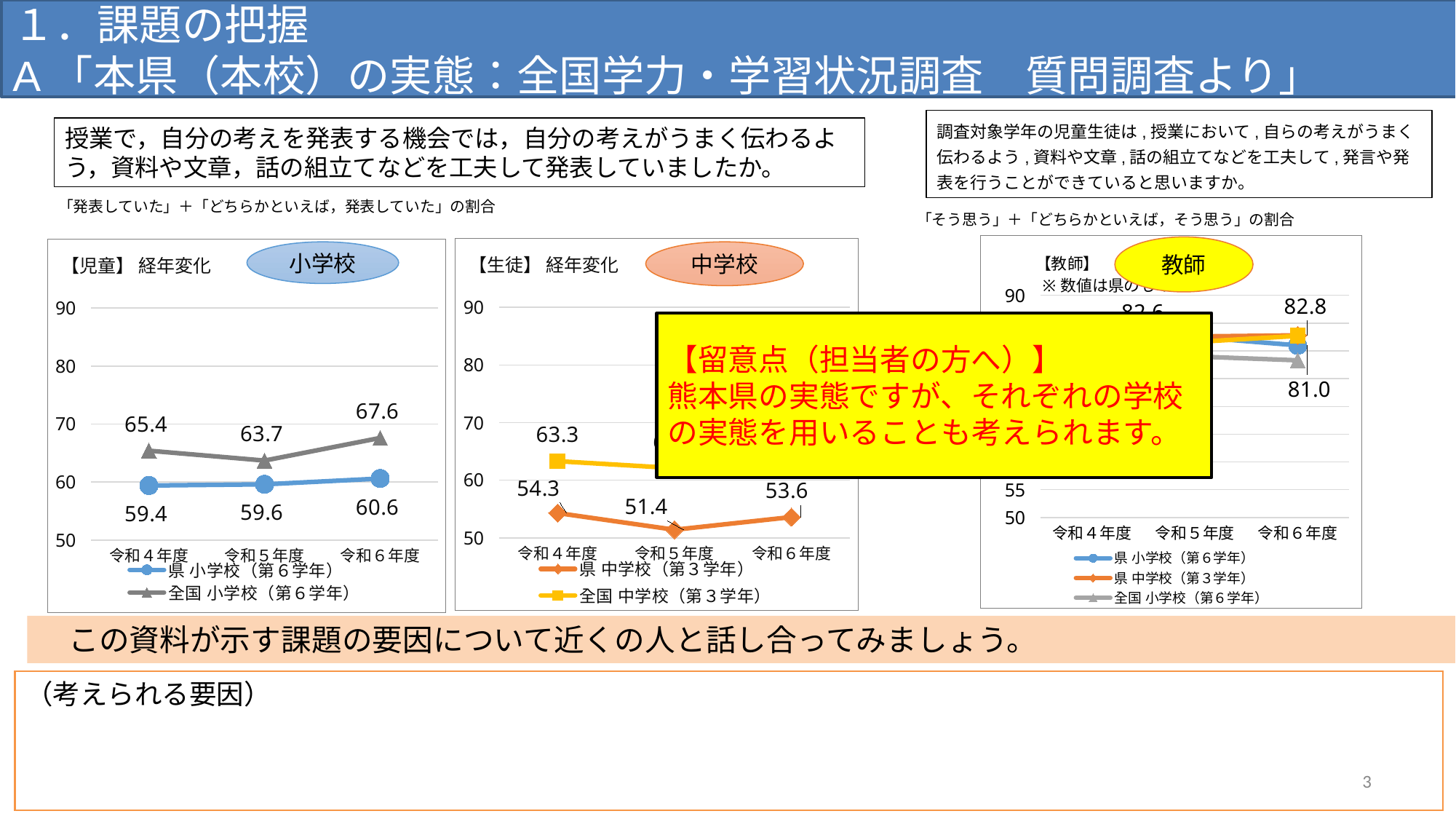
What type of chart is the left chart (【児童】経年変化 小学校)? line chart In the left chart (【児童】経年変化 小学校), does the 県 小学校（第６学年） series rise or fall from 令和４年度 to 令和６年度? rise In the middle chart (【生徒】経年変化 中学校), what is the difference between the 県 中学校（第３学年） values in 令和４年度 and 令和６年度? 0.7 In the left chart (【児童】経年変化 小学校), what is the difference between the 全国 and 県 values in 令和６年度? 7.0 In the middle chart (【生徒】経年変化 中学校), in which year is the 県 中学校（第３学年） value lowest? 令和５年度 In the left chart (【児童】経年変化 小学校), what is the value for 全国 小学校（第６学年） in 令和４年度? 65.4 In the middle chart (【生徒】経年変化 中学校), what is the value for 県 中学校（第３学年） in 令和５年度? 51.4 In the left chart (【児童】経年変化 小学校), what is the value for 全国 小学校（第６学年） in 令和５年度? 63.7 In the left chart (【児童】経年変化 小学校), what is the value for 県 小学校（第６学年） in 令和６年度? 60.6 In the left chart (【児童】経年変化 小学校), in which year is the 全国 小学校（第６学年） value highest? 令和６年度 In the middle chart (【生徒】経年変化 中学校), what is the value for 全国 中学校（第３学年） in 令和４年度? 63.3 In the left chart (【児童】経年変化 小学校), how many series does the legend list? 2